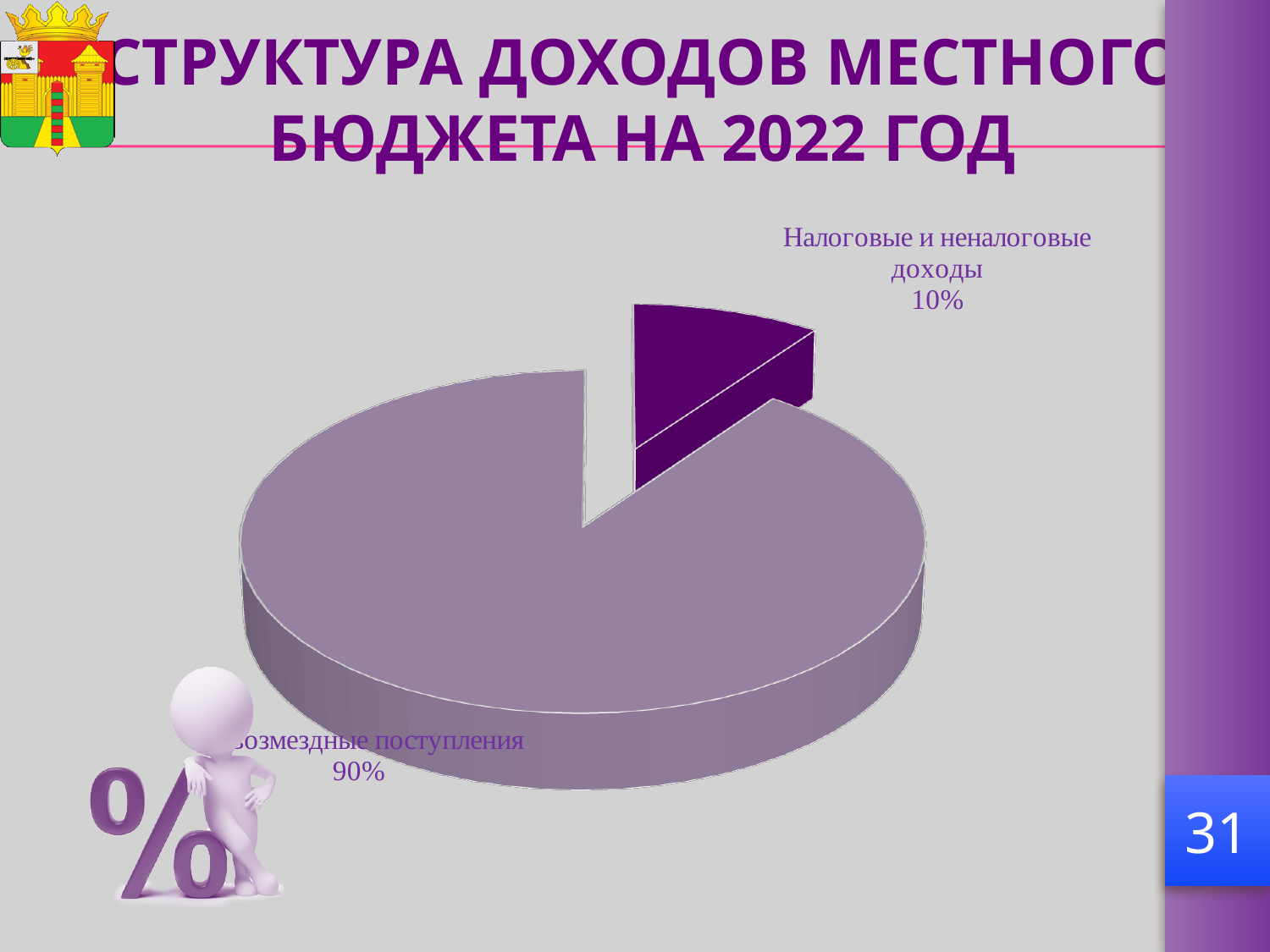
Which slice of the pie is drawn in dark purple and pulled out from the rest of the pie? Налоговые и неналоговые доходы What share of the pie is labelled "Безвозмездные поступления"? 90% How many slices does the pie chart have? 2 What is the title of the slide containing the pie chart? СТРУКТУРА ДОХОДОВ МЕСТНОГО БЮДЖЕТА НА 2022 ГОД What share of the pie is labelled "Налоговые и неналоговые доходы"? 10% What is the difference in percentage points between the "Безвозмездные поступления" slice and the "Налоговые и неналоговые доходы" slice? 80 percentage points What kind of chart is shown on the slide? Pie chart What is the total of the two percentages shown on the pie chart? 100% Which slice of the pie is the smallest? Налоговые и неналоговые доходы Which slice of the pie is the largest? Безвозмездные поступления Which is larger: the share for "Налоговые и неналоговые доходы" or the share for "Безвозмездные поступления"? Безвозмездные поступления